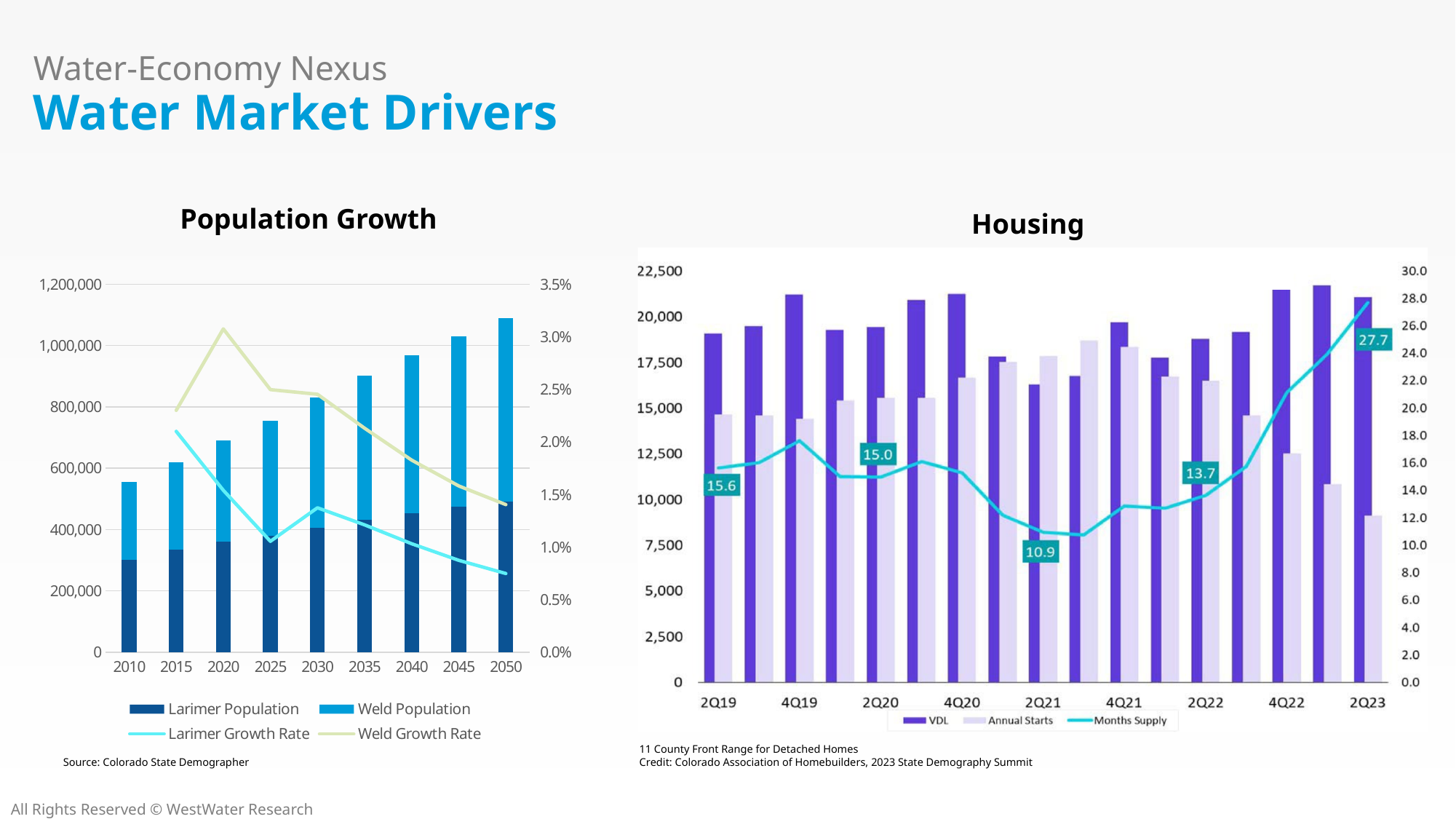
In the Housing chart, is the labeled Months Supply larger at 2Q19 or at 2Q22? 2Q19 In the Housing chart, what is the Months Supply value labeled at 2Q21? 10.9 In the Housing chart, what is the Months Supply value labeled at 2Q23? 27.7 In the Population Growth chart, does the Weld Population rise or fall from 2010 to 2050? rise In the Population Growth chart, how many series does the legend list? 4 In the Housing chart, is the VDL value for 2Q23 greater or less than 20,000? greater In the Housing chart, what is the difference between the labeled Months Supply values at 2Q23 and 2Q21? 16.8 In the Housing chart, what is the Months Supply value labeled at 2Q19? 15.6 In the Population Growth chart, how many years are shown on the x axis? 9 In the Housing chart, which quarter has the highest labeled Months Supply value? 2Q23 In the Housing chart, how many series does the legend list? 3 In the Population Growth chart, is the Larimer Growth Rate for 2050 greater or less than 1.0%? less